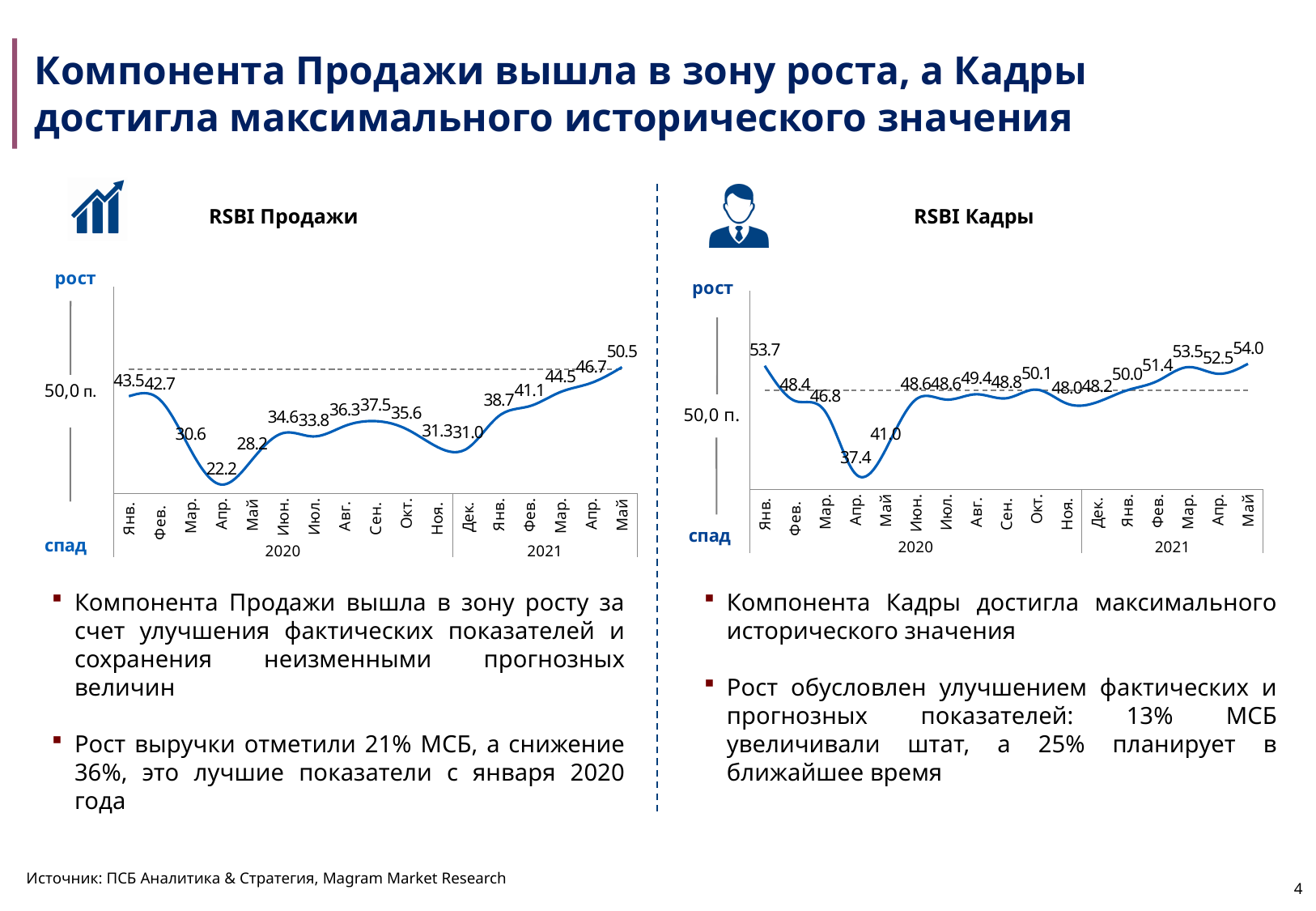
On the RSBI Продажи chart, which month has the lowest value? Апр. 2020 On the RSBI Кадры chart, which month has the highest value? Май 2021 How many data points are plotted on the RSBI Продажи chart? 17 On the RSBI Продажи chart, what is the difference between the values for Май 2021 and Апр. 2020? 28.3 What type of chart is the RSBI Кадры chart? line chart On the RSBI Продажи chart, what is the value for Май 2021? 50.5 On the RSBI Кадры chart, which is larger, the value for Мар. 2021 or the value for Апр. 2021? Мар. 2021 On the RSBI Кадры chart, what is the difference between the values for Янв. 2020 and Фев. 2020? 5.3 On the RSBI Кадры chart, which month has the lowest value? Апр. 2020 On the RSBI Кадры chart, what is the value for Май 2021? 54.0 On the RSBI Продажи chart, do the values rise or fall from Дек. 2020 to Май 2021? rise On the RSBI Продажи chart, what is the value for Янв. 2020? 43.5